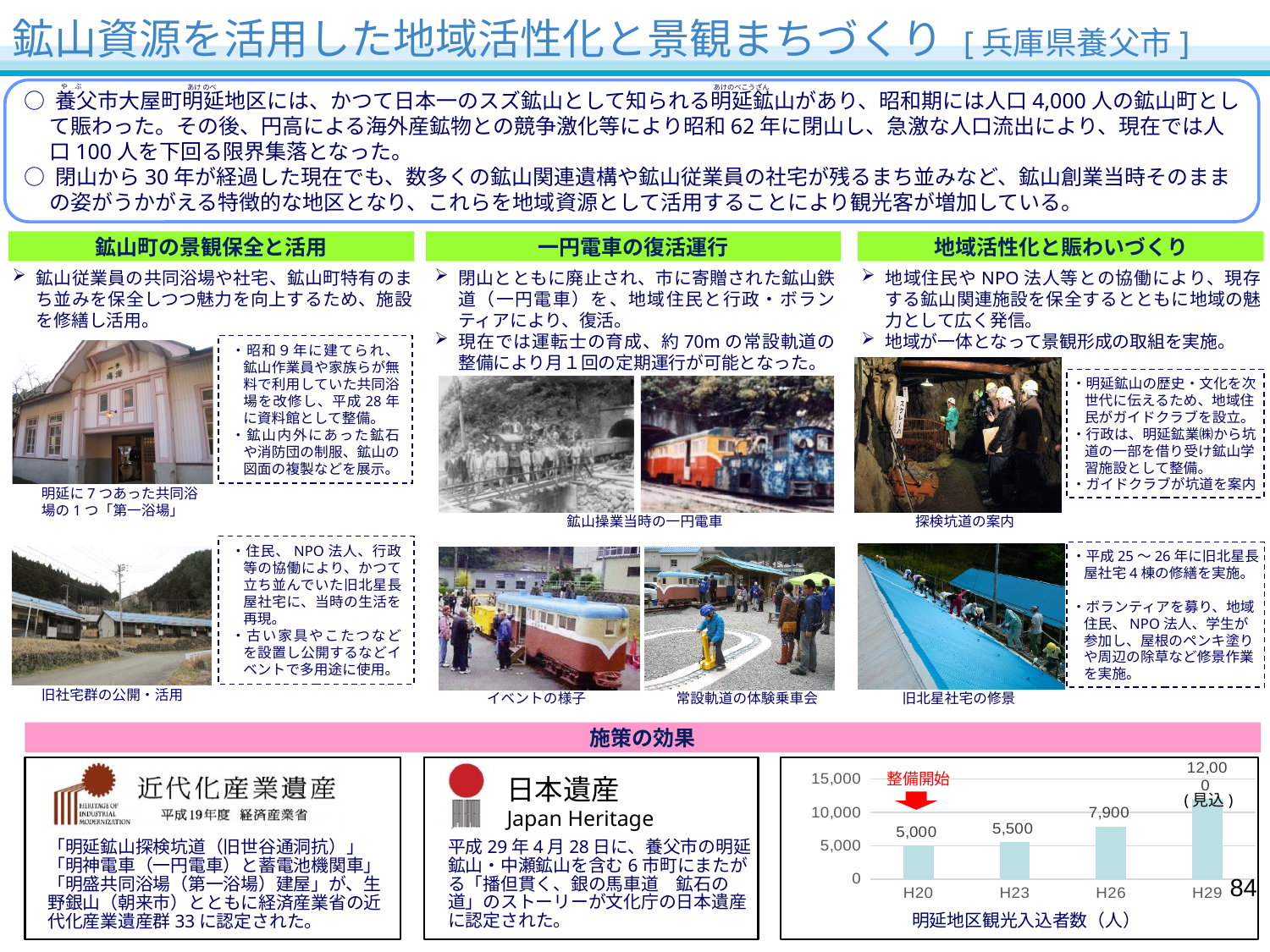
In the 明延地区観光入込者数 chart, what is the value for H23? 5,500 In the 明延地区観光入込者数 chart, which year has the lowest value? H20 In the 明延地区観光入込者数 chart, what is the difference between the values for H26 and H23? 2,400 In the 明延地区観光入込者数 chart, what is the value for H26? 7,900 In the 明延地区観光入込者数 chart, do the values rise or fall from H20 to H29? rise How many bars (years) are shown in the 明延地区観光入込者数 chart? 4 In the 明延地区観光入込者数 chart, which is larger, the value for H26 or the value for H23? H26 In the 明延地区観光入込者数 chart, what is the value for H20? 5,000 In the 明延地区観光入込者数 chart, what is the value for H29? 12,000 In the 明延地区観光入込者数 chart, what is the difference between the values for H29 and H20? 7,000 What type of chart is shown at the bottom right of the slide (明延地区観光入込者数)? bar chart In the 明延地区観光入込者数 chart, which year has the highest value? H29